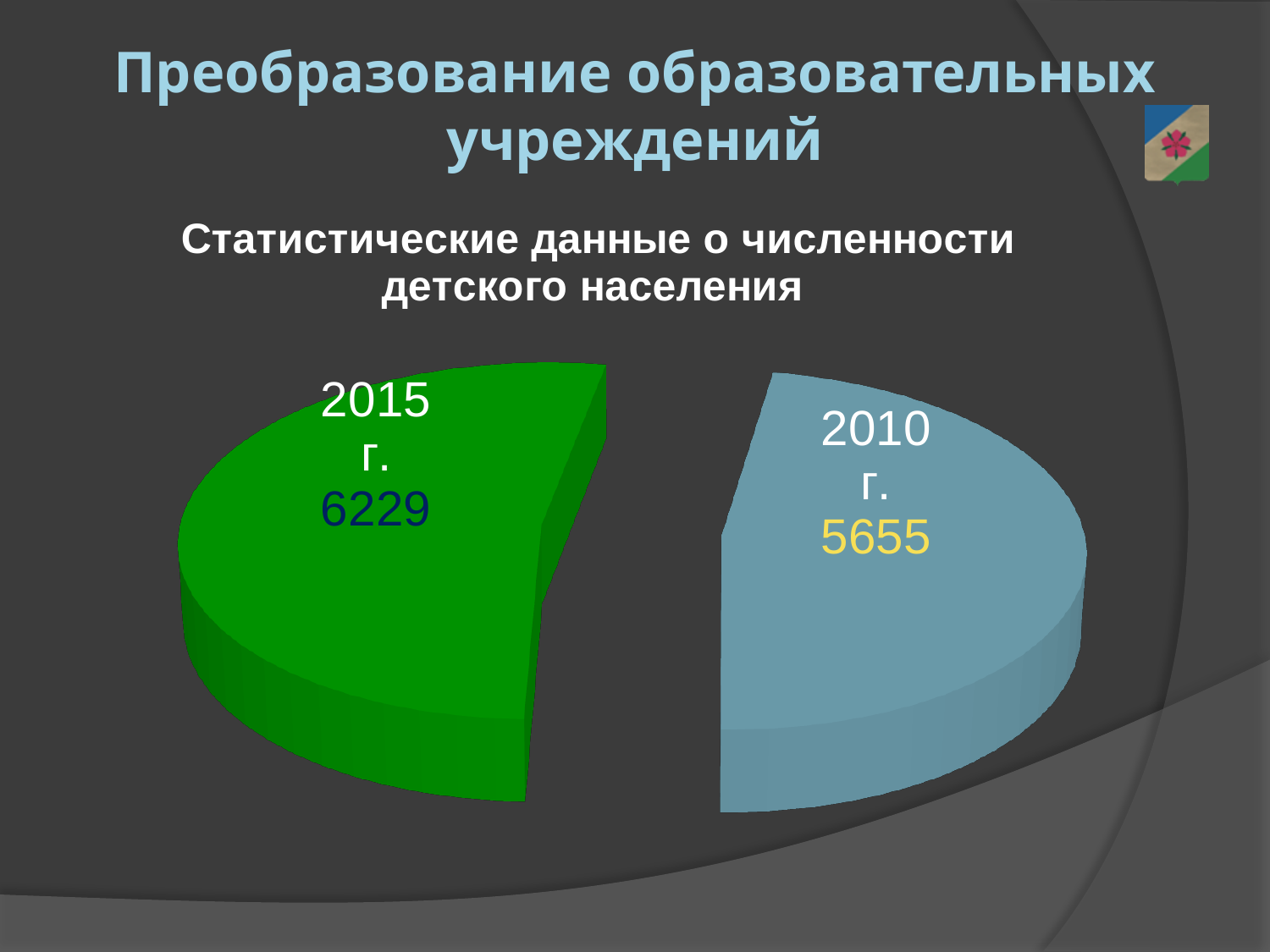
Which slice has the lowest value? 2010 г. Which slice has the highest value? 2015 г. What type of chart is shown on the slide? pie chart What is the value shown for the 2010 г. slice? 5655 How many slices does the pie chart have? 2 What is the value shown for the 2015 г. slice? 6229 What is the difference between the values for 2015 г. and 2010 г.? 574 What is the total of the two values shown in the pie chart? 11884 Which is larger, the value for 2015 г. or the value for 2010 г.? 2015 г. What is the title of the chart? Статистические данные о численности детского населения What colour is the 2015 г. slice? green